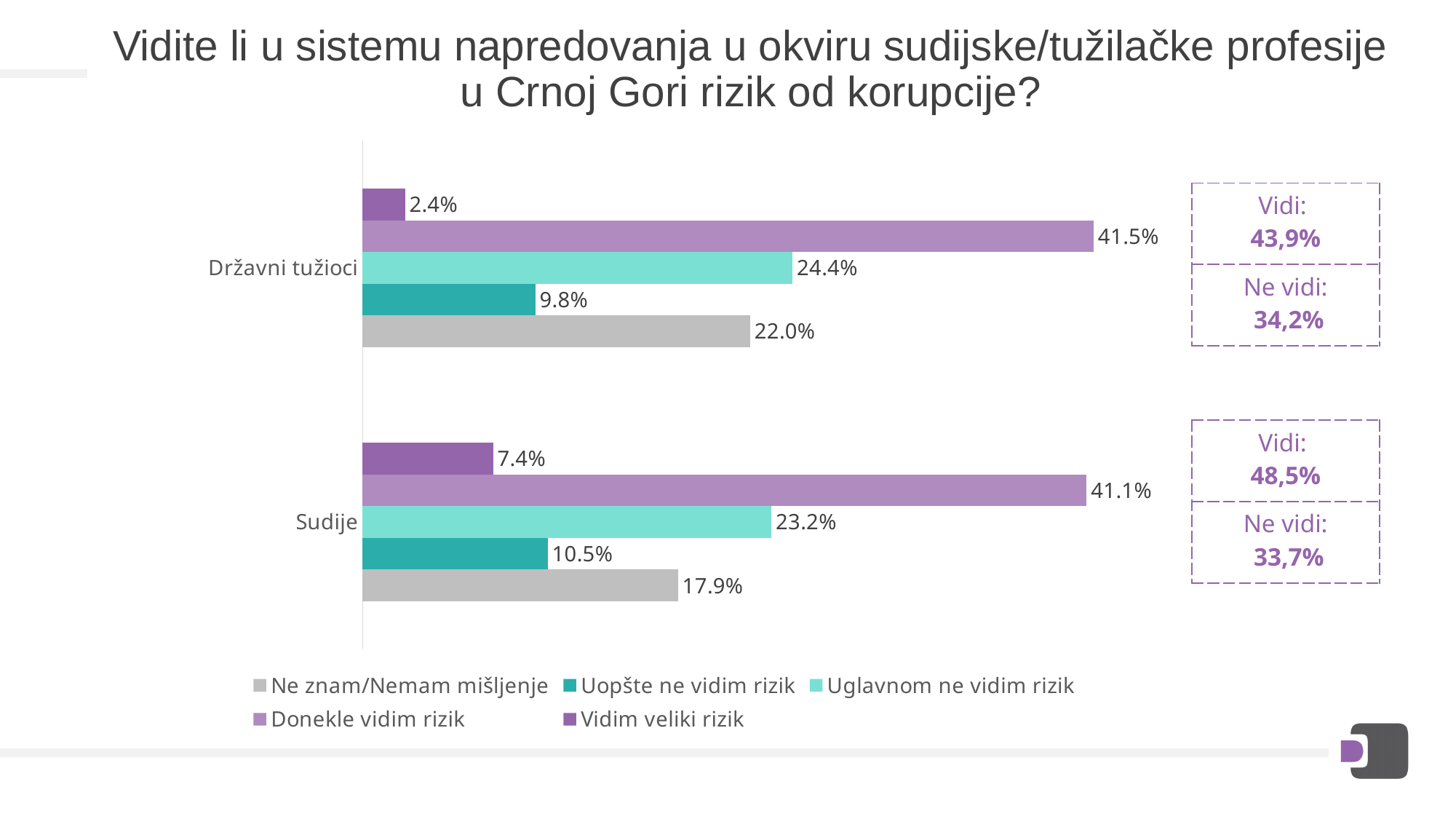
What is the value for "Donekle vidim rizik" for Državni tužioci? 41.5% What is the difference between the "Uglavnom ne vidim rizik" values for Državni tužioci and Sudije? 1.2% What is the value for "Uopšte ne vidim rizik" for Sudije? 10.5% What colour are the "Ne znam/Nemam mišljenje" bars? Grey What kind of chart is shown on the slide? Bar chart Which series has the lowest value for Državni tužioci? Vidim veliki rizik Which is larger: "Ne znam/Nemam mišljenje" for Državni tužioci or for Sudije? Državni tužioci What is the value for "Vidim veliki rizik" for Sudije? 7.4% Which series has the highest value for Sudije? Donekle vidim rizik How many series does the legend list? 5 What is the value for "Ne znam/Nemam mišljenje" for Državni tužioci? 22.0% How many categories are shown on the vertical axis? 2